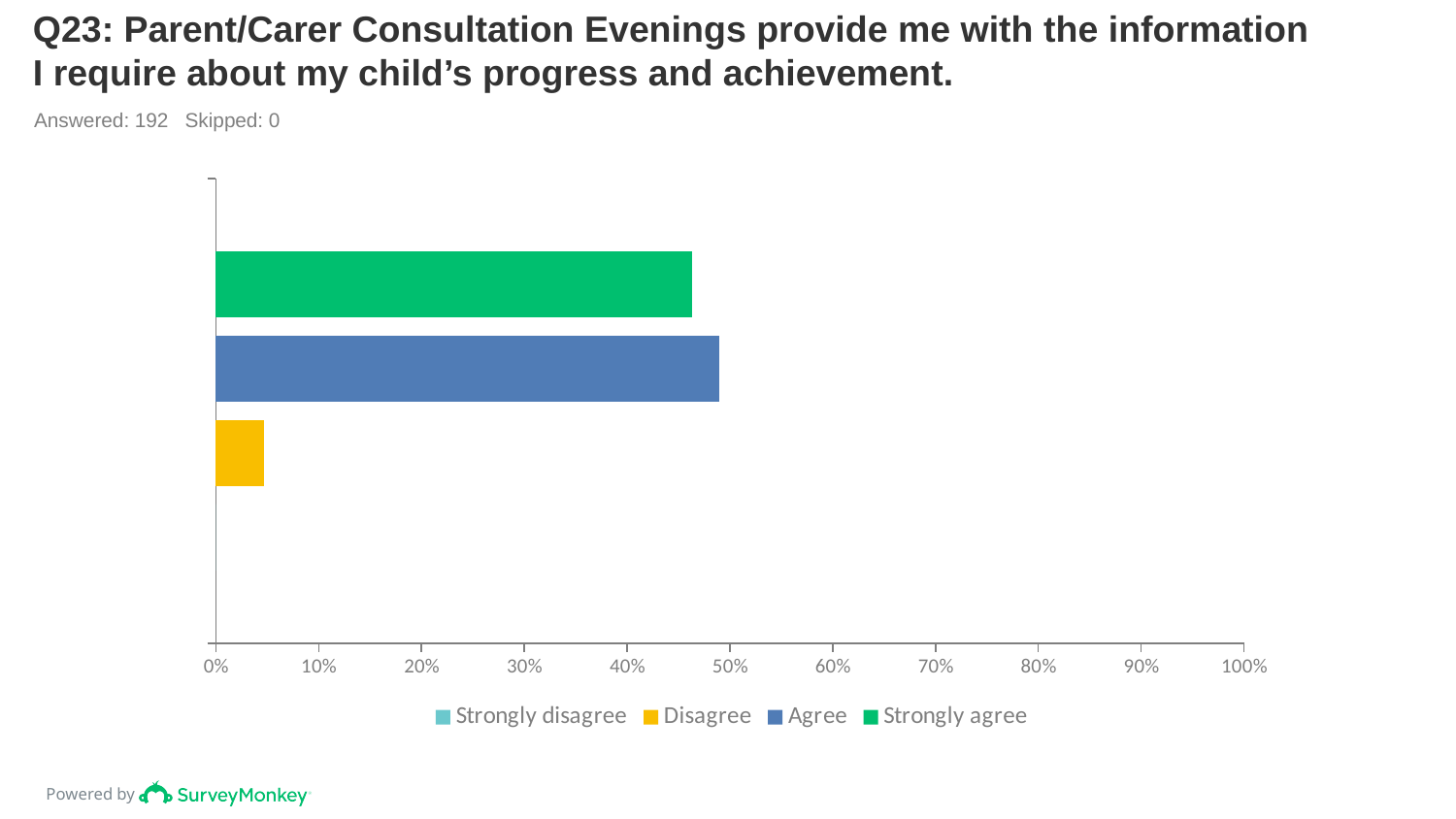
Is the value for Disagree greater or less than 10%? less Which is larger, the value for Agree or the value for Strongly agree? Agree How many respondents answered this question according to the slide? 192 Which response category has the longest bar? Agree Which is larger, the value for Disagree or the value for Agree? Agree Is the value for Strongly agree greater or less than 40%? greater What colour is the bar for Disagree? yellow What kind of chart is shown on the slide? bar chart How many series does the legend list? 4 Is the value for Agree greater or less than 40%? greater